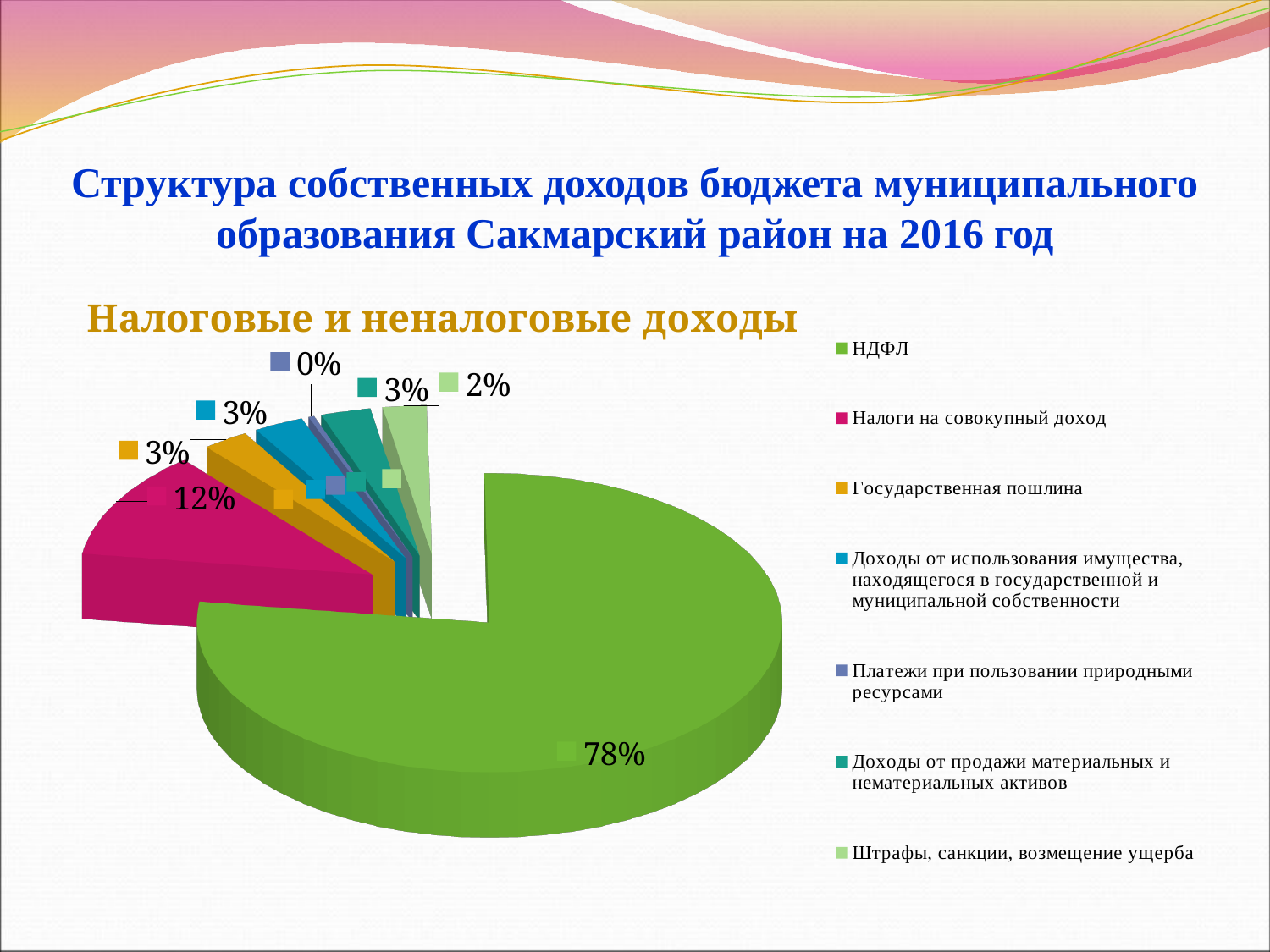
What share of the pie does Платежи при пользовании природными ресурсами have? 0% What is the difference between the shares of НДФЛ and Налоги на совокупный доход? 66% What share of the pie does Штрафы, санкции, возмещение ущерба have? 2% What share of the pie does НДФЛ have? 78% Which category has the largest share of the pie? НДФЛ Which category has the smallest share of the pie? Платежи при пользовании природными ресурсами What kind of chart is shown on the slide? pie chart How many categories does the legend list? 7 Which is larger: the share of Налоги на совокупный доход or the share of Штрафы, санкции, возмещение ущерба? Налоги на совокупный доход What is the title of the chart? Налоговые и неналоговые доходы